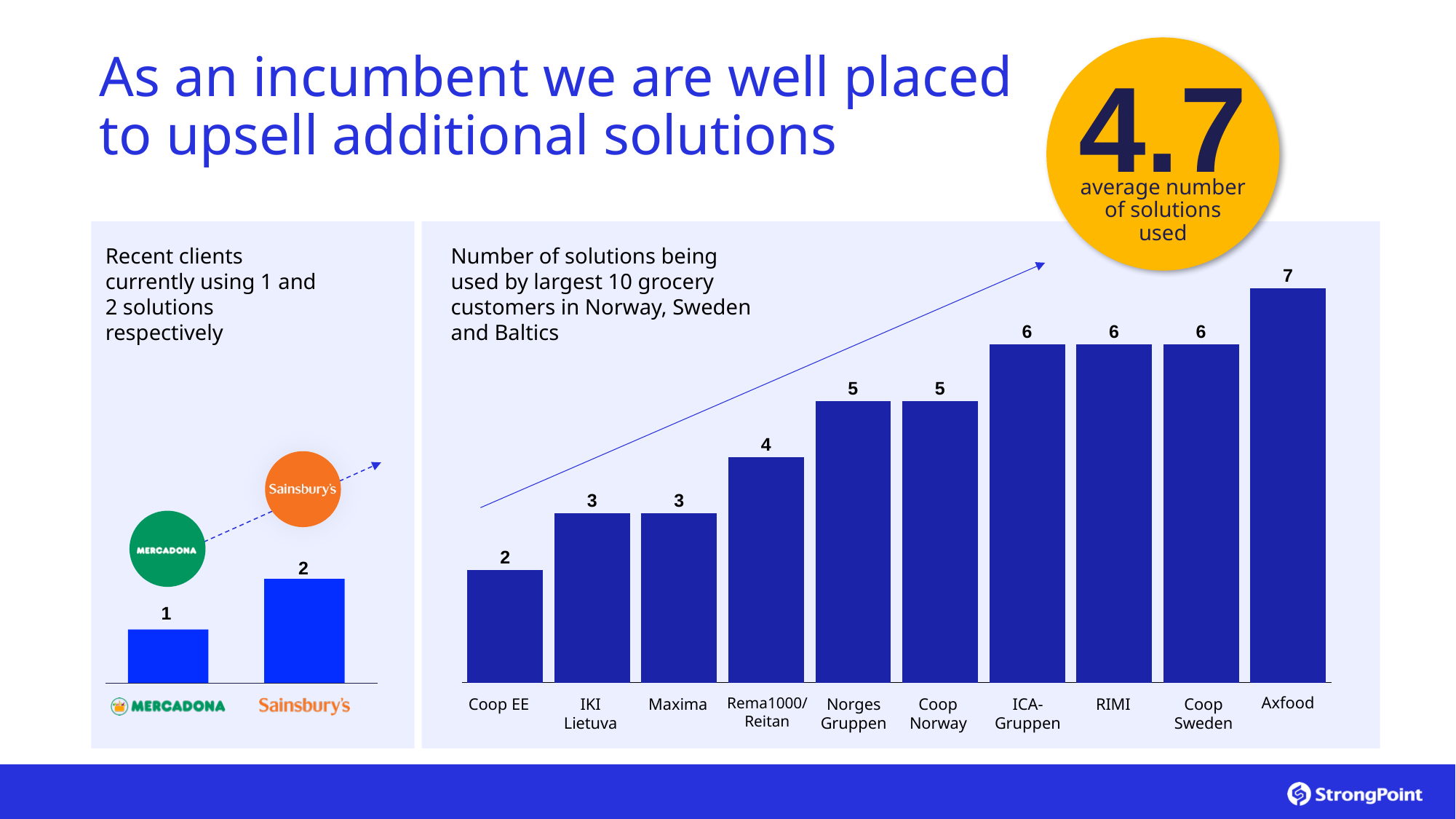
What kind of chart is the right-hand chart? Bar chart In the left-hand chart, which client uses more solutions, Mercadona or Sainsbury's? Sainsbury's In the right-hand chart (number of solutions used by largest 10 grocery customers), how many solutions does Axfood use? 7 In the right-hand chart, do the values rise or fall from left to right? Rise In the left-hand chart (recent clients), how many solutions does Sainsbury's currently use? 2 In the right-hand chart, which uses more solutions, Norges Gruppen or RIMI? RIMI How many customers are shown in the right-hand chart? 10 In the right-hand chart, which customer uses the fewest solutions? Coop EE In the right-hand chart, what is the difference between the number of solutions used by Axfood and by Coop EE? 5 In the right-hand chart, how many solutions does Rema1000/Reitan use? 4 In the right-hand chart, which customer uses the most solutions? Axfood What average number of solutions used is shown in the yellow circle on the slide? 4.7